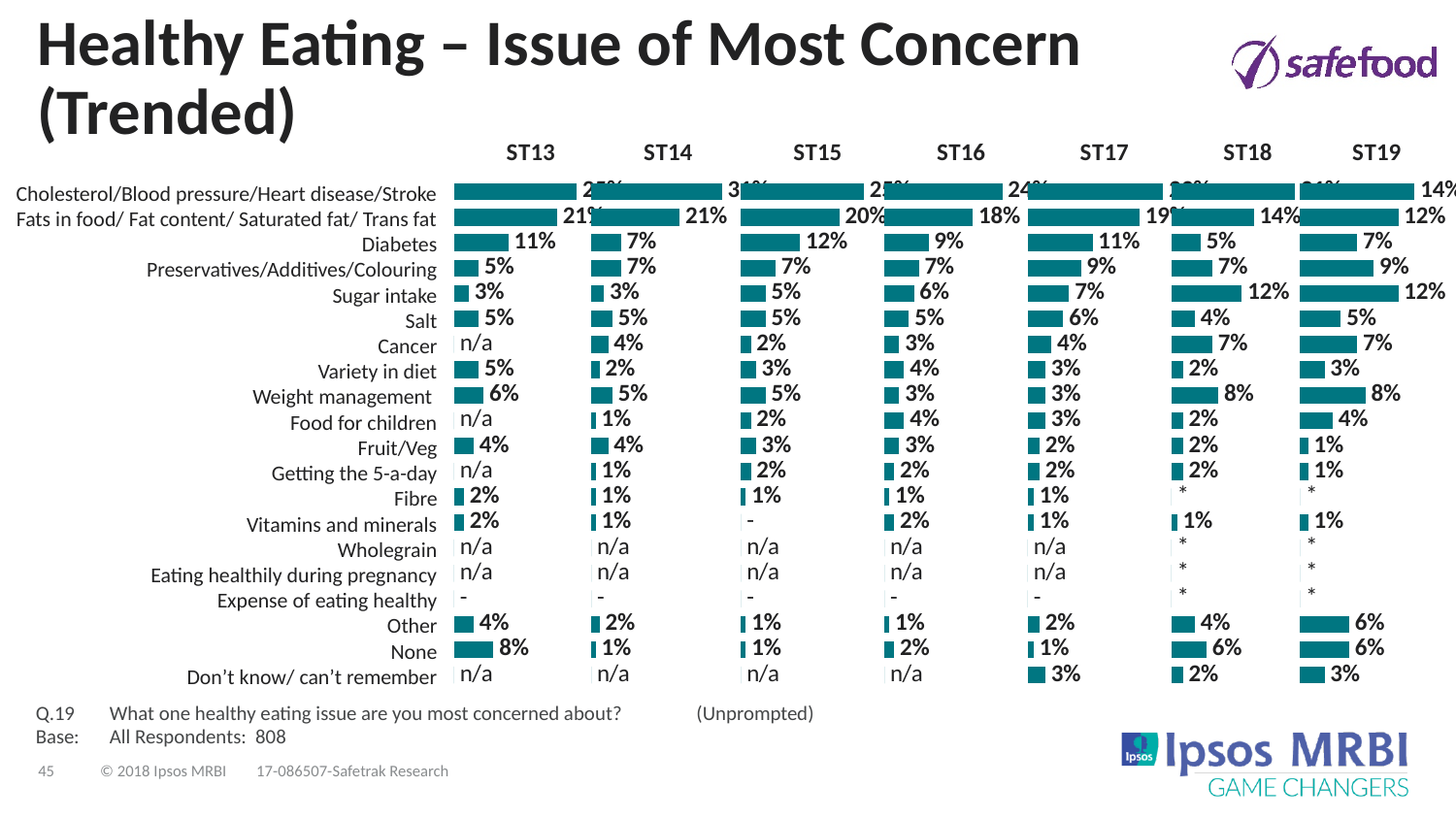
How many survey waves (columns) are shown in the chart? 7 In the ST17 column, what is the value for Don't know/ can't remember? 3% Does the value for Fats in food/ Fat content/ Saturated fat/ Trans fat rise or fall from ST14 to ST19? fall In the ST18 column, what is the value for Weight management? 8% What is the title of the slide? Healthy Eating – Issue of Most Concern (Trended) In the ST13 column, what is the value for Diabetes? 11% In the ST19 column, what is the value for Sugar intake? 12% In the ST15 column, which is larger: Diabetes or Preservatives/Additives/Colouring? Diabetes Does the value for Sugar intake rise or fall from ST13 to ST19? rise In the ST16 column, what is the value for Fats in food/ Fat content/ Saturated fat/ Trans fat? 18% What is the difference between the Sugar intake values in ST18 and ST13? 9 percentage points What kind of chart is used on this slide? bar chart